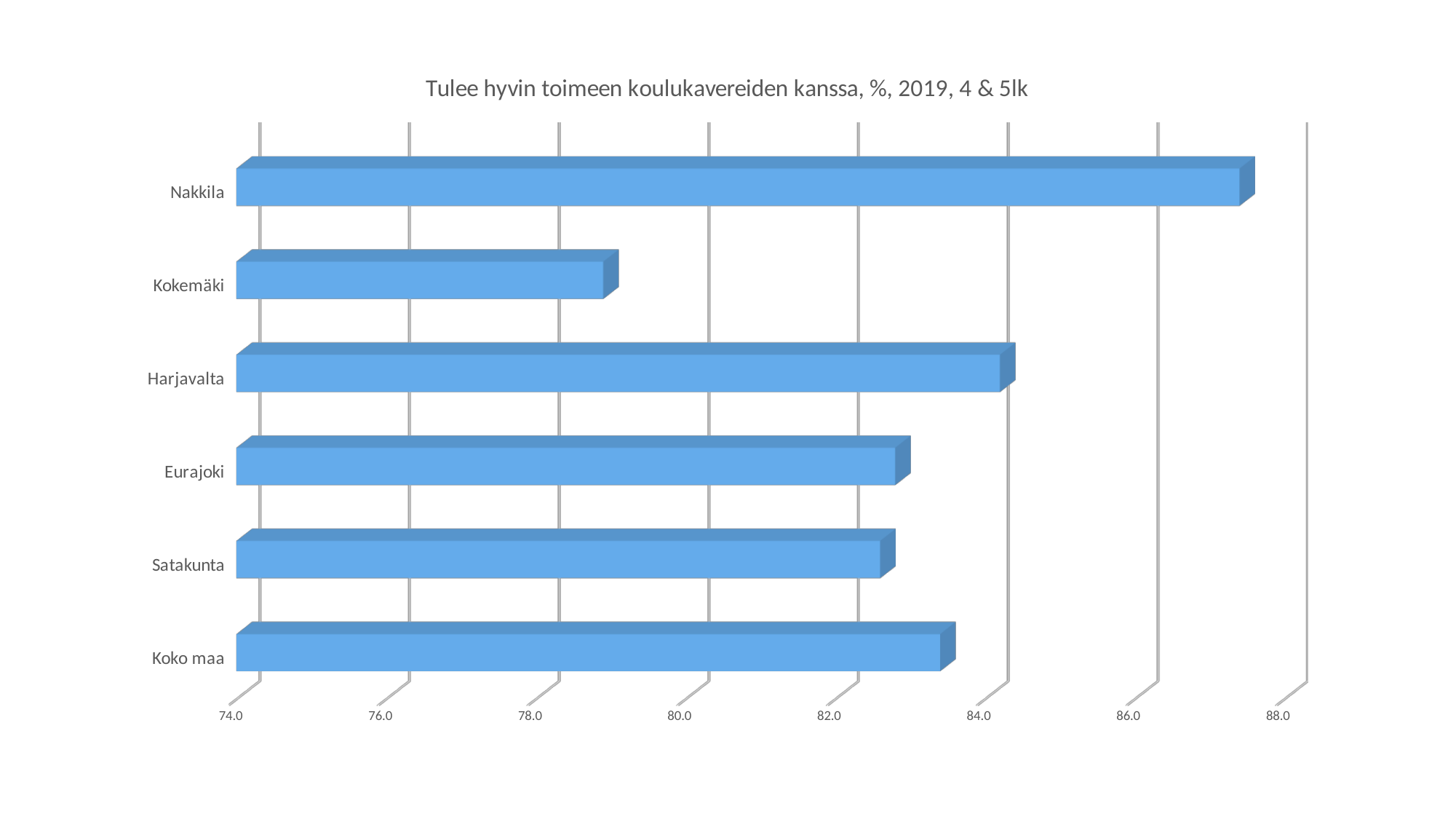
What kind of chart is shown on the slide? bar chart How many categories are shown in the chart? 6 Which has a larger value, Harjavalta or Eurajoki? Harjavalta Is the value for Koko maa greater or less than 82.0? greater Is the value for Kokemäki greater or less than 80.0? less Is the value for Harjavalta greater or less than 82.0? greater Which category has the lowest value? Kokemäki Which category has the highest value? Nakkila Which has a larger value, Koko maa or Satakunta? Koko maa What is the title of the chart? Tulee hyvin toimeen koulukavereiden kanssa, %, 2019, 4 & 5lk